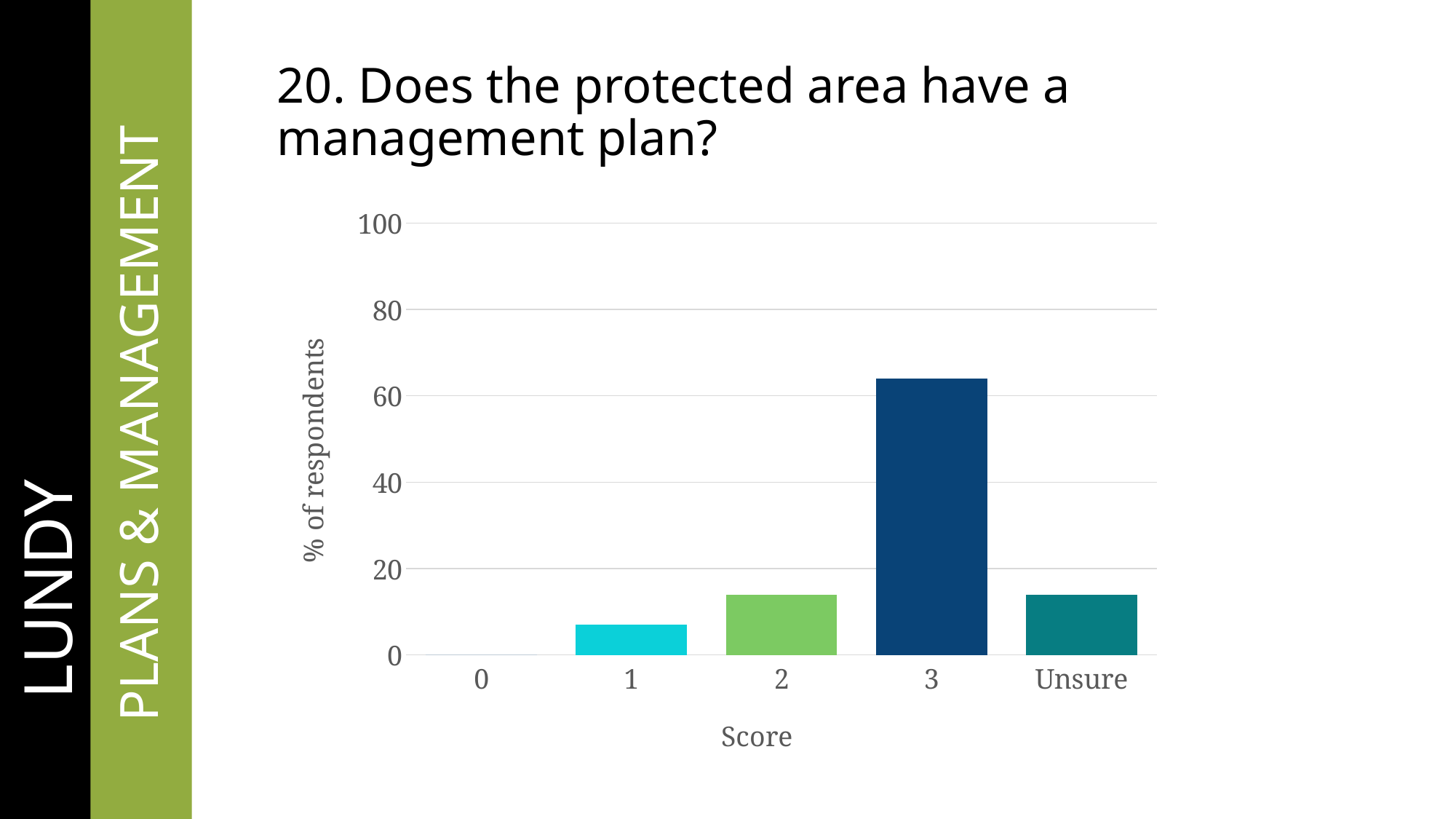
Is the value for score 3 greater or less than 80? less What kind of chart is shown on the slide? bar chart Is the value for Unsure greater or less than 20? less Which score category has the highest percentage of respondents? 3 Which has a higher percentage of respondents, score 1 or Unsure? Unsure What is the label on the y axis of the chart? % of respondents What is the percentage of respondents for score 0? 0 Is the value for score 3 greater or less than 60? greater How many score categories are shown on the x axis? 5 Which score category has the lowest percentage of respondents? 0 Which has a higher percentage of respondents, score 2 or score 3? 3